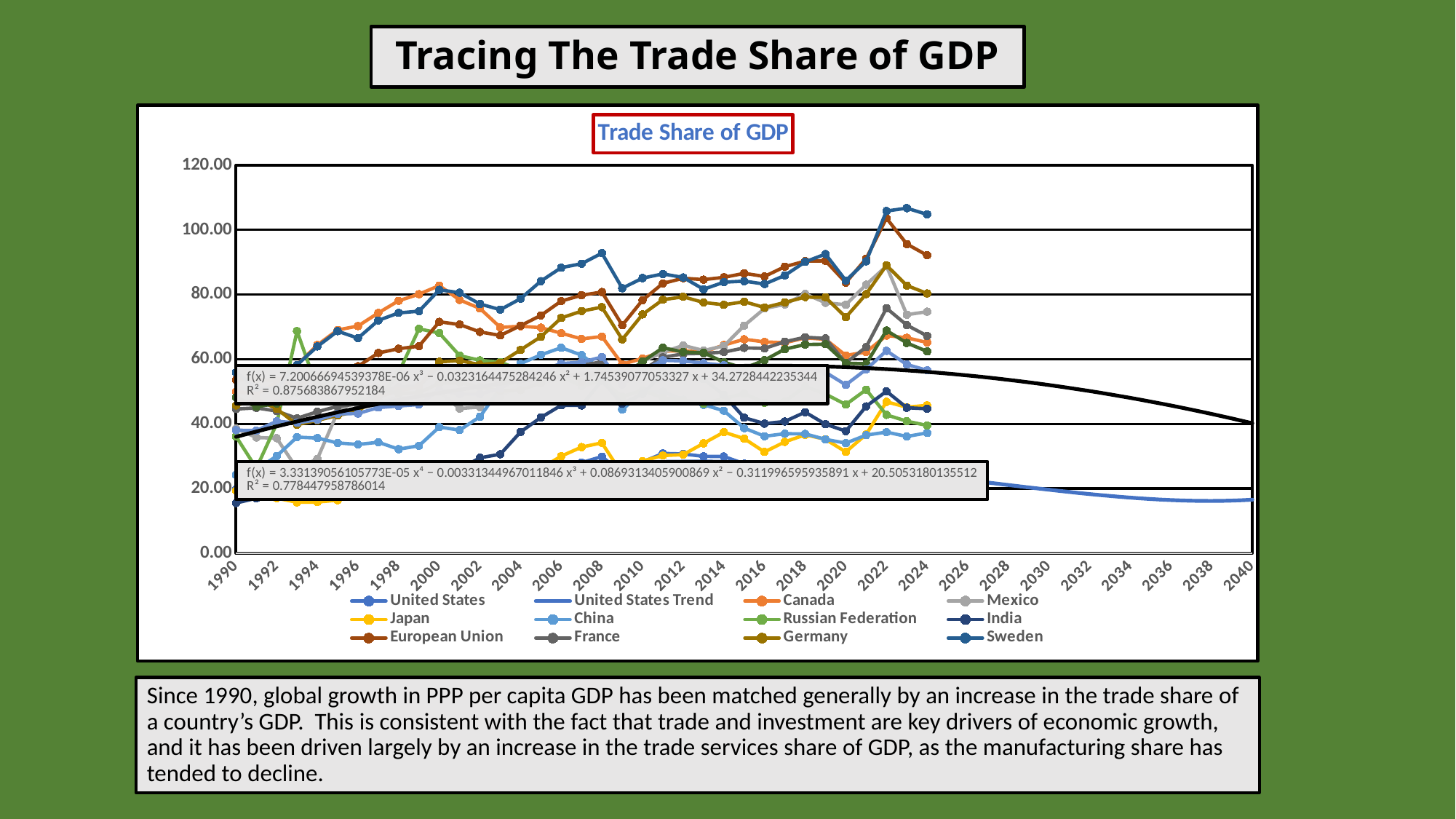
What is the highest value shown on the y axis of the chart? 120.00 Is the value for Sweden in 2024 greater or less than 100? greater In 2024, which is larger: the value for the European Union or the value for Japan? European Union In 2024, which is larger: the value for Sweden or the value for China? Sweden Is the value for the European Union in 2024 greater or less than 80? greater What kind of chart is shown on the slide? line chart Does the United States Trend line rise or fall between 2026 and 2040? fall Is the value for Canada in 2024 greater or less than 60? greater How many series does the legend of the Trade Share of GDP chart list? 12 What is the title of the chart? Trade Share of GDP Which series reaches the highest value on the chart? Sweden